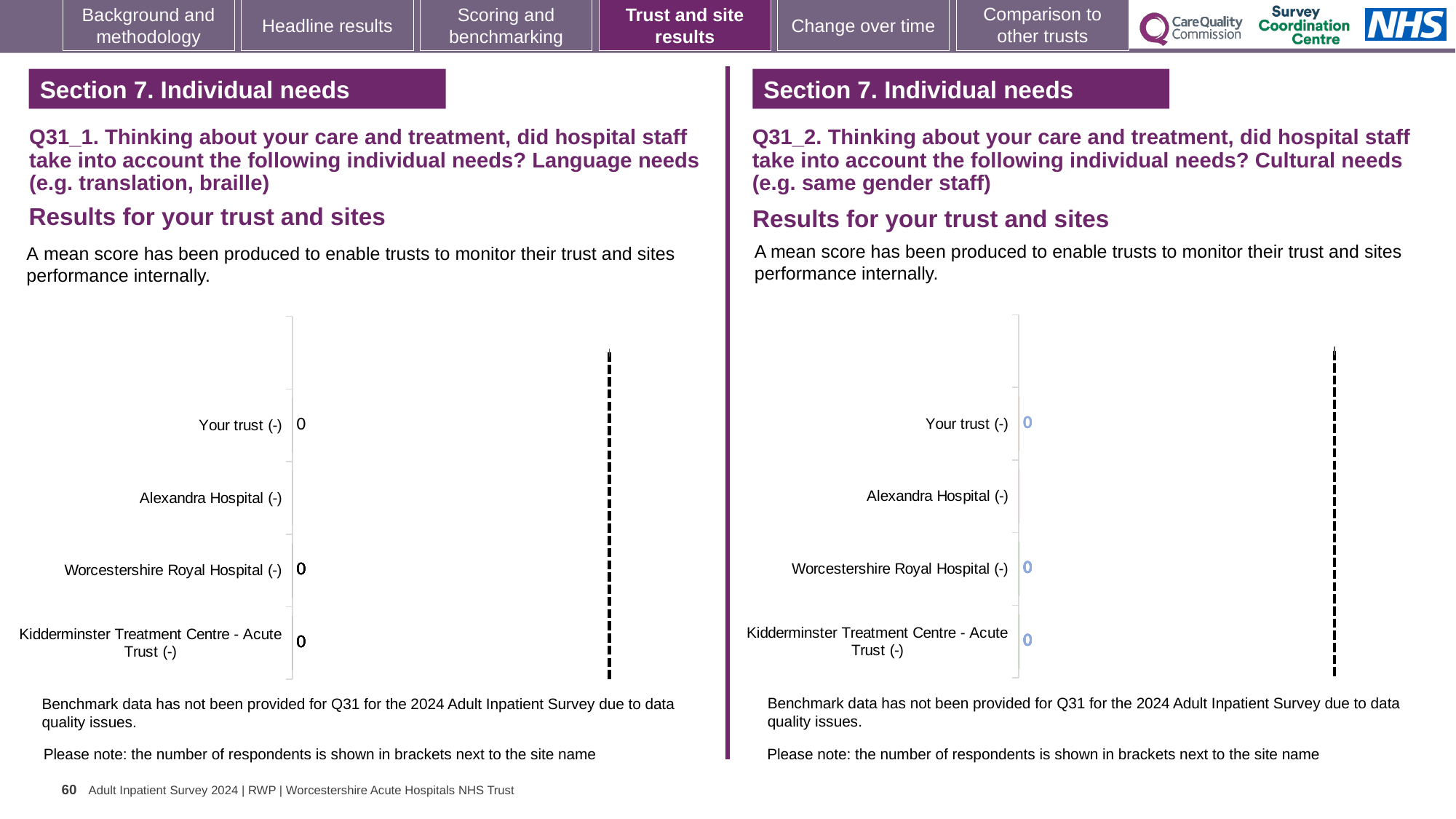
On the left chart (Q31_1, Language needs), what value is shown for Kidderminster Treatment Centre - Acute Trust (-)? 0 How many categories are listed on the left chart (Q31_1, Language needs)? 4 On the left chart (Q31_1, Language needs), which category has no data label shown? Alexandra Hospital (-) What kind of chart is the left chart (Q31_1, Language needs)? Bar chart On the left chart (Q31_1, Language needs), what value is shown for Your trust (-)? 0 What kind of chart is the right chart (Q31_2, Cultural needs)? Bar chart Which section heading appears above both charts on the slide? Section 7. Individual needs On the right chart (Q31_2, Cultural needs), what value is shown for Worcestershire Royal Hospital (-)? 0 On the left chart (Q31_1, Language needs), what value is shown for Worcestershire Royal Hospital (-)? 0 How many categories are listed on the right chart (Q31_2, Cultural needs)? 4 On the right chart (Q31_2, Cultural needs), what value is shown for Kidderminster Treatment Centre - Acute Trust (-)? 0 On the right chart (Q31_2, Cultural needs), what value is shown for Your trust (-)? 0